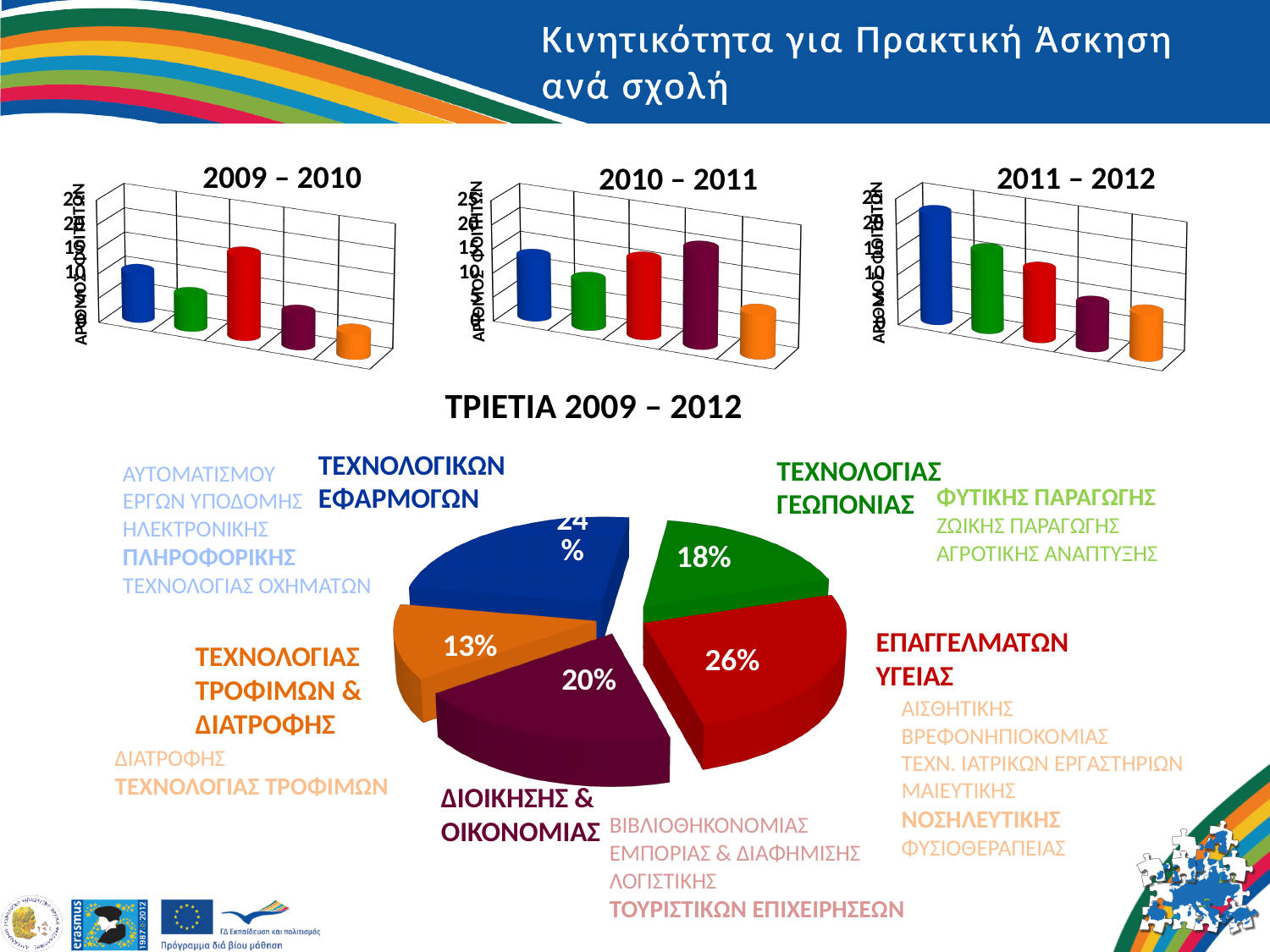
In the pie chart ΤΡΙΕΤΙΑ 2009 – 2012, what percentage is shown for ΤΕΧΝΟΛΟΓΙΑΣ ΓΕΩΠΟΝΙΑΣ? 18% In the pie chart ΤΡΙΕΤΙΑ 2009 – 2012, what is the difference in percentage points between ΕΠΑΓΓΕΛΜΑΤΩΝ ΥΓΕΙΑΣ and ΔΙΟΙΚΗΣΗΣ & ΟΙΚΟΝΟΜΙΑΣ? 6 In the 2011 – 2012 chart at the top right, which bar is the tallest? The first (blue) bar How many slices does the pie chart ΤΡΙΕΤΙΑ 2009 – 2012 have? 5 In the pie chart ΤΡΙΕΤΙΑ 2009 – 2012, which school has the largest share? ΕΠΑΓΓΕΛΜΑΤΩΝ ΥΓΕΙΑΣ In the pie chart ΤΡΙΕΤΙΑ 2009 – 2012, what percentage is shown for ΤΕΧΝΟΛΟΓΙΑΣ ΤΡΟΦΙΜΩΝ & ΔΙΑΤΡΟΦΗΣ? 13% What kind of chart is the ΤΡΙΕΤΙΑ 2009 – 2012 chart? Pie chart How many bars does the 2011 – 2012 chart at the top right have? 5 In the pie chart ΤΡΙΕΤΙΑ 2009 – 2012, which school has the smallest share? ΤΕΧΝΟΛΟΓΙΑΣ ΤΡΟΦΙΜΩΝ & ΔΙΑΤΡΟΦΗΣ What kind of chart is the 2009 – 2010 chart at the top left? Bar chart In the pie chart ΤΡΙΕΤΙΑ 2009 – 2012, which is larger: ΤΕΧΝΟΛΟΓΙΚΩΝ ΕΦΑΡΜΟΓΩΝ or ΔΙΟΙΚΗΣΗΣ & ΟΙΚΟΝΟΜΙΑΣ? ΤΕΧΝΟΛΟΓΙΚΩΝ ΕΦΑΡΜΟΓΩΝ In the pie chart ΤΡΙΕΤΙΑ 2009 – 2012, what percentage is shown for ΕΠΑΓΓΕΛΜΑΤΩΝ ΥΓΕΙΑΣ? 26%